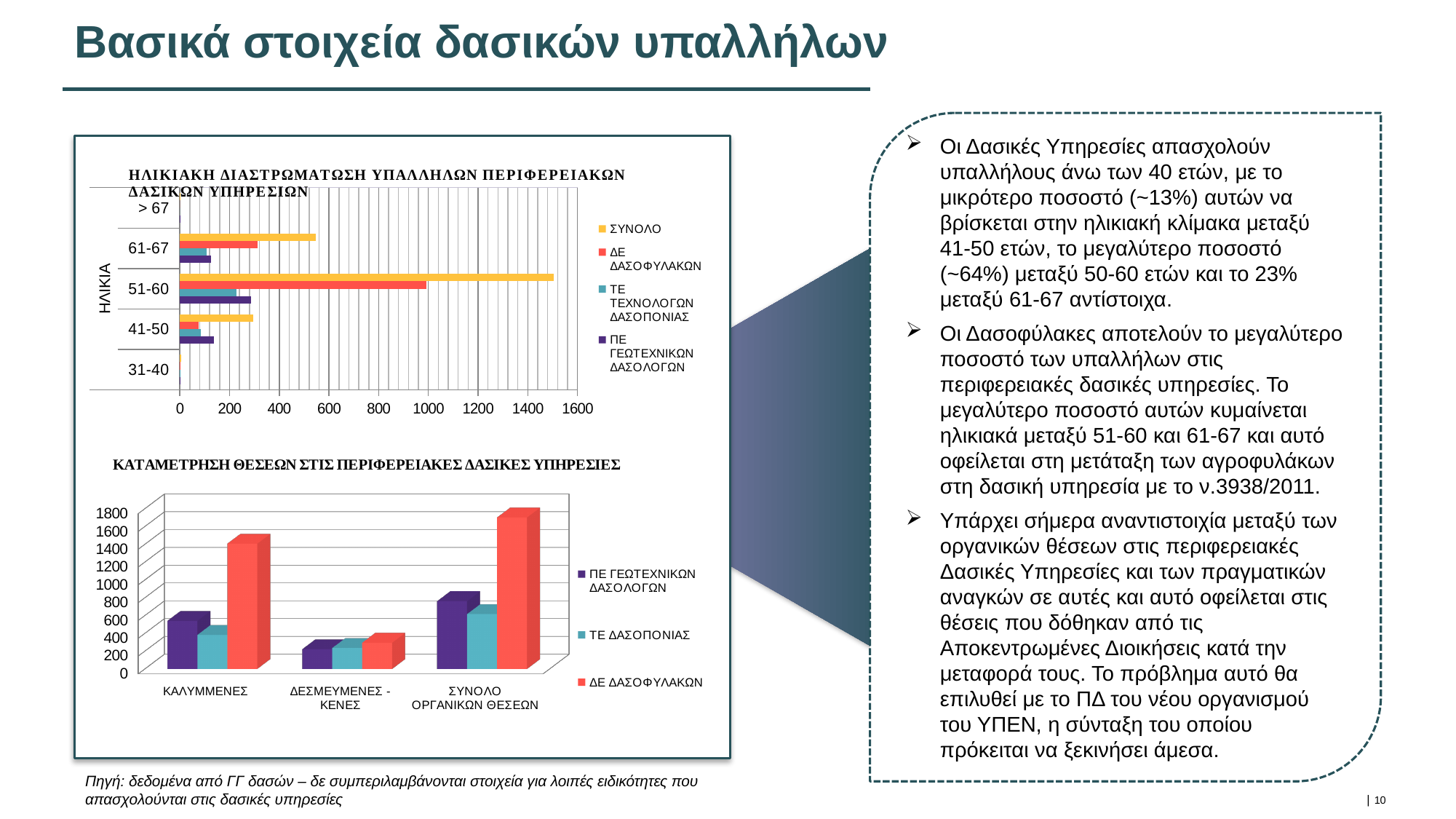
How many series does the legend of the bottom chart, 'ΚΑΤΑΜΕΤΡΗΣΗ ΘΕΣΕΩΝ ΣΤΙΣ ΠΕΡΙΦΕΡΕΙΑΚΕΣ ΔΑΣΙΚΕΣ ΥΠΗΡΕΣΙΕΣ', list? 3 In the top chart, is the ΣΥΝΟΛΟ value for 61-67 greater or less than 400? greater In the top chart, which age group has the highest ΣΥΝΟΛΟ value? 51-60 In the bottom chart, is the ΔΕ ΔΑΣΟΦΥΛΑΚΩΝ value for ΣΥΝΟΛΟ ΟΡΓΑΝΙΚΩΝ ΘΕΣΕΩΝ greater or less than 1600? greater In the top chart, which is larger: the ΣΥΝΟΛΟ value for 61-67 or for 41-50? 61-67 In the top chart, is the ΣΥΝΟΛΟ value for 51-60 greater or less than 1400? greater How many series does the legend of the top chart list? 4 In the bottom chart, which is larger for ΚΑΛΥΜΜΕΝΕΣ: ΠΕ ΓΕΩΤΕΧΝΙΚΩΝ ΔΑΣΟΛΟΓΩΝ or ΤΕ ΔΑΣΟΠΟΝΙΑΣ? ΠΕ ΓΕΩΤΕΧΝΙΚΩΝ ΔΑΣΟΛΟΓΩΝ How many age categories are shown on the y axis of the top chart? 5 What kind of chart is the top chart, 'ΗΛΙΚΙΑΚΗ ΔΙΑΣΤΡΩΜΑΤΩΣΗ ΥΠΑΛΛΗΛΩΝ ΠΕΡΙΦΕΡΕΙΑΚΩΝ ΔΑΣΙΚΩΝ ΥΠΗΡΕΣΙΩΝ'? Bar chart In the bottom chart, which series has the highest value for ΚΑΛΥΜΜΕΝΕΣ? ΔΕ ΔΑΣΟΦΥΛΑΚΩΝ